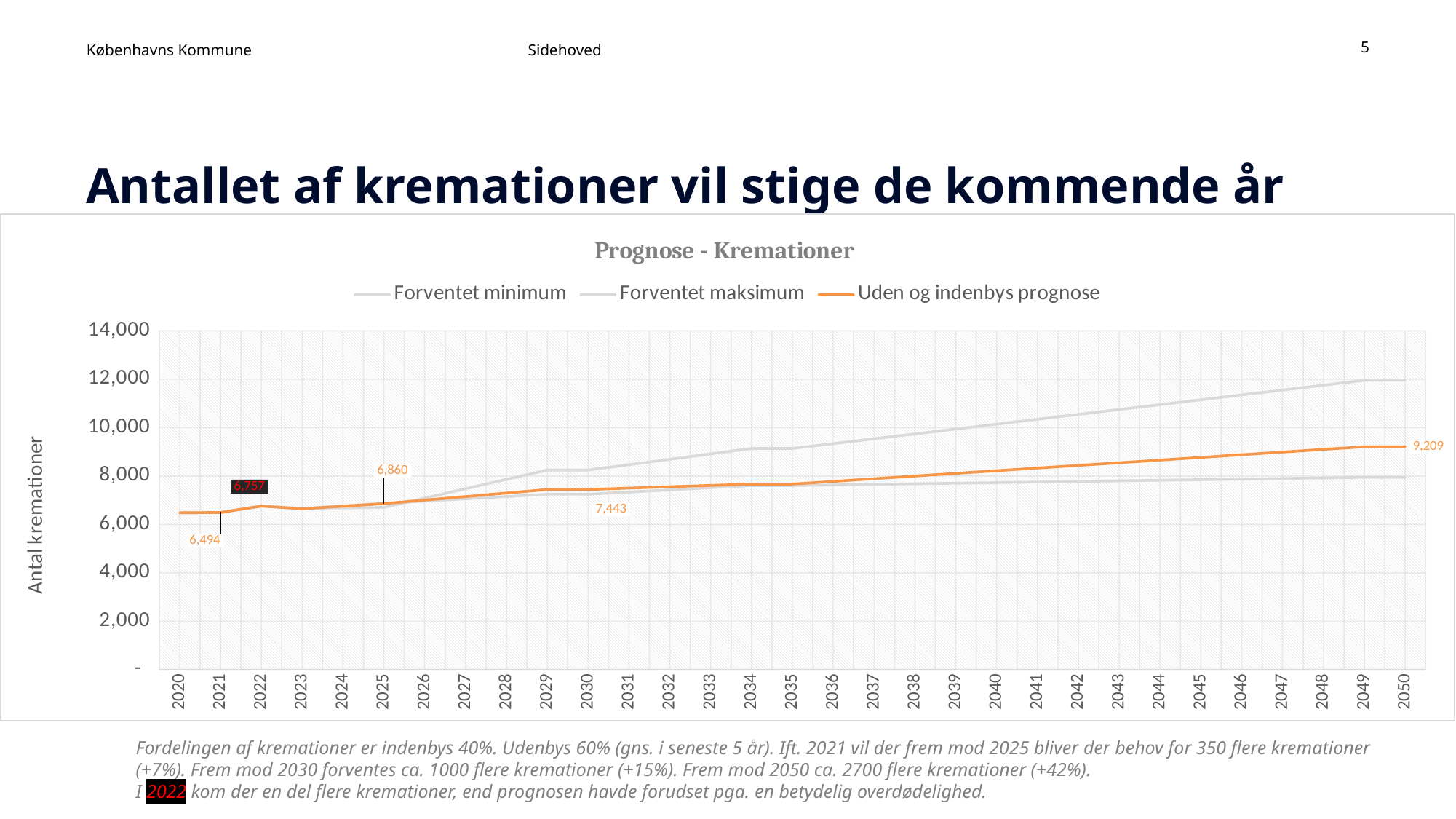
How many years are shown on the x axis of the chart? 31 Is the value for 'Forventet maksimum' in 2050 greater or less than 10,000? greater What kind of chart is shown on the slide? line chart What is the title of the chart? Prognose - Kremationer What is the value of the 'Uden og indenbys prognose' series in 2050? 9,209 How many series does the legend of the chart list? 3 What is the value of the 'Uden og indenbys prognose' series in 2030? 7,443 What is the value of the 'Uden og indenbys prognose' series in 2021? 6,494 What is the value of the 'Uden og indenbys prognose' series in 2025? 6,860 Does the 'Uden og indenbys prognose' series rise or fall from 2020 to 2050? rise What is the difference between the 'Uden og indenbys prognose' values for 2025 and 2021? 366 What is the difference between the 'Uden og indenbys prognose' values for 2050 and 2030? 1,766